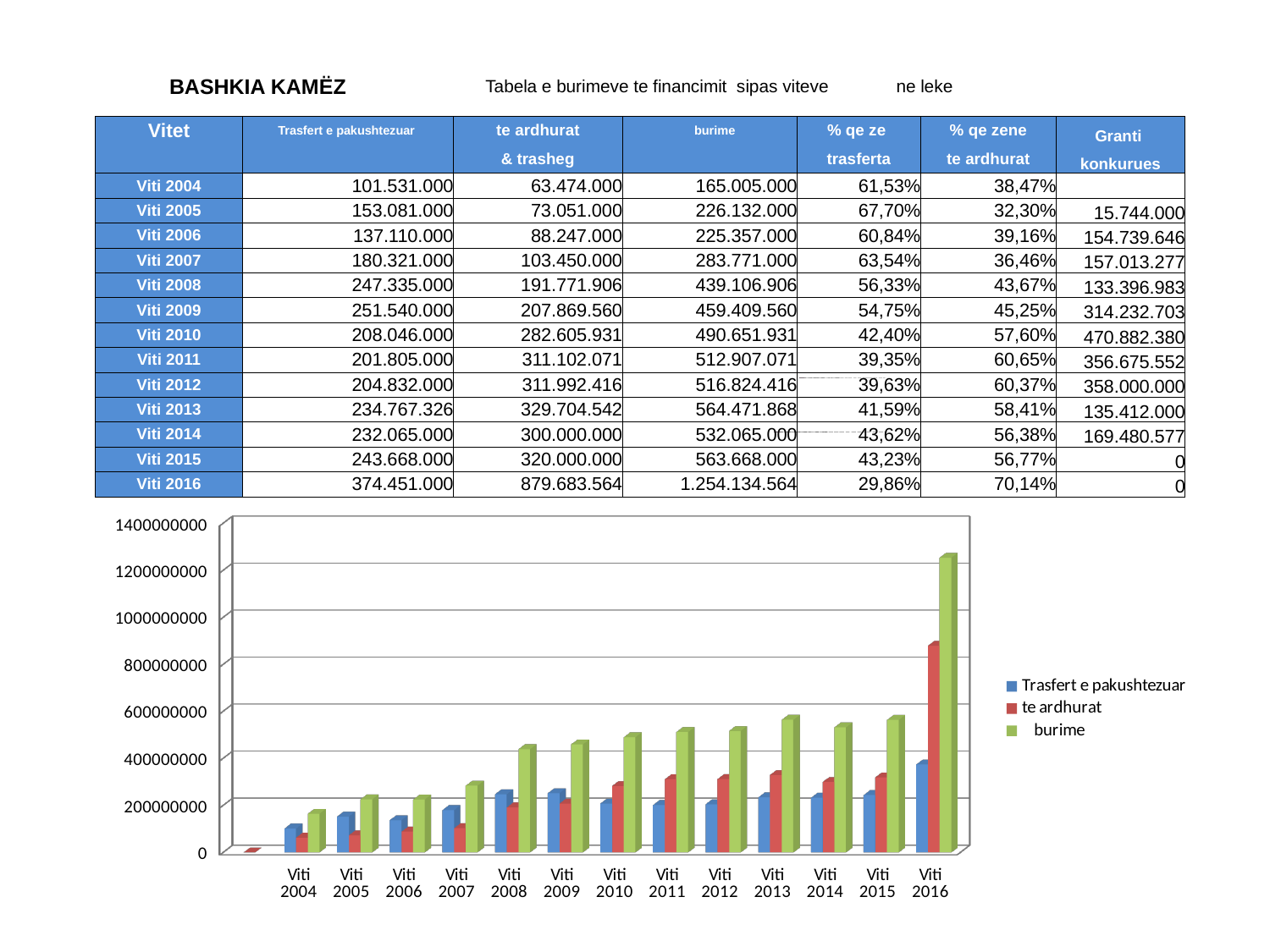
Do the burime bars generally rise or fall from Viti 2004 to Viti 2016? rise What kind of chart is shown below the table? bar chart In Viti 2016, which is larger: the te ardhurat bar or the Trasfert e pakushtezuar bar? te ardhurat Which labeled year has the shortest burime bar in the chart? Viti 2004 Which year has the tallest burime bar in the chart? Viti 2016 Is the te ardhurat bar for Viti 2016 greater or less than 800000000? greater Is the Trasfert e pakushtezuar bar for Viti 2004 greater or less than 200000000? less How many years are labeled on the chart's x axis? 13 Which colour represents the burime series in the chart legend? green How many series does the chart legend list? 3 According to the table, what is the burime value for Viti 2016? 1.254.134.564 Is the burime bar for Viti 2016 greater or less than 1200000000? greater